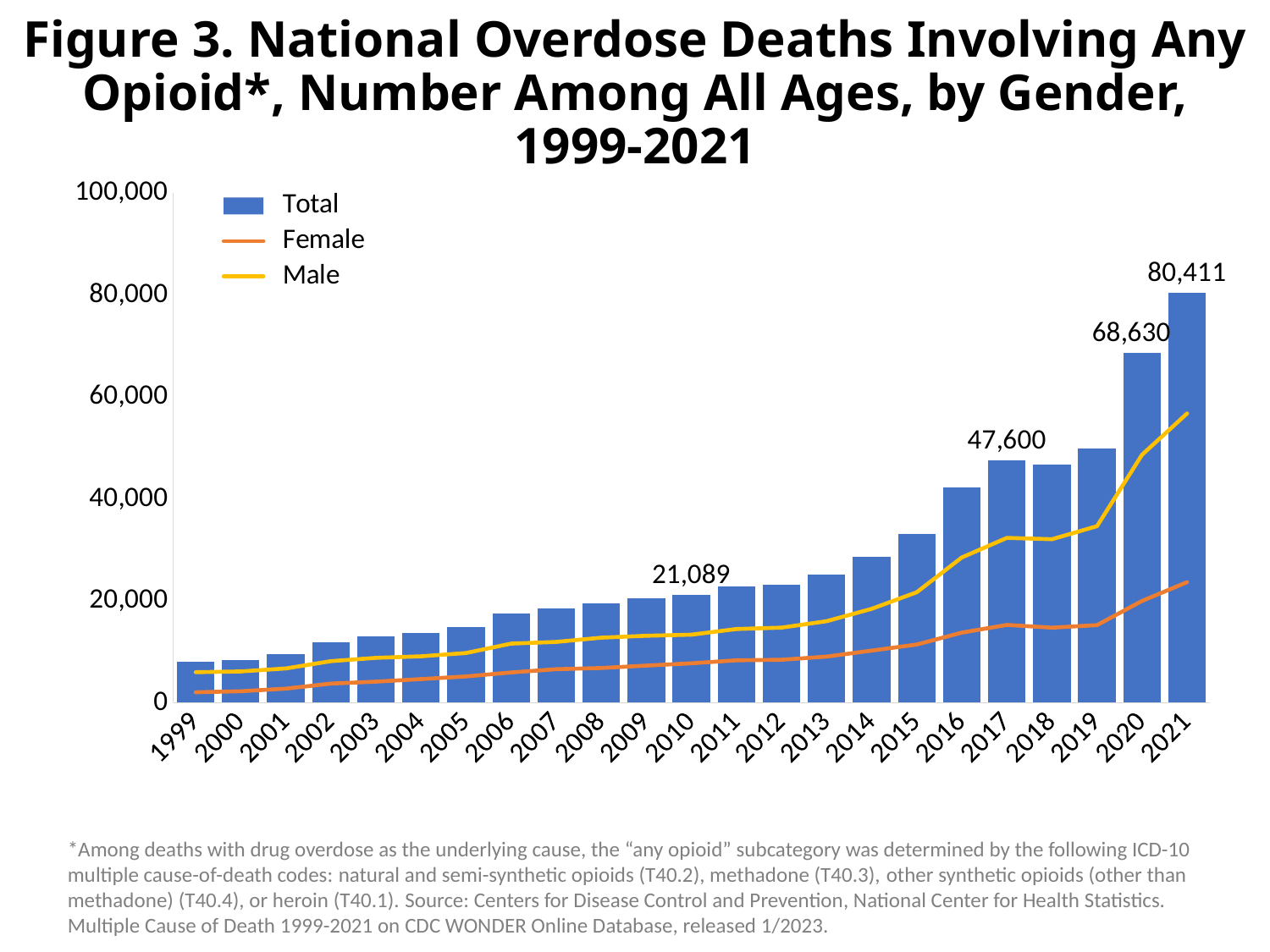
Which year has the highest Total? 2021 What is the Total value for 2021? 80,411 Is the Total for 2016 greater or less than 40,000? greater How many series does the legend list? 3 How many years are shown on the x axis? 23 Which year has the lowest Total? 1999 Does the Total generally rise or fall from 1999 to 2021? rise What is the difference between the Total for 2021 and the Total for 2020? 11,781 What is the Total value for 2017? 47,600 What is the Total value for 2010? 21,089 Is the Male value for 2021 greater or less than 60,000? less What is the Total value for 2020? 68,630